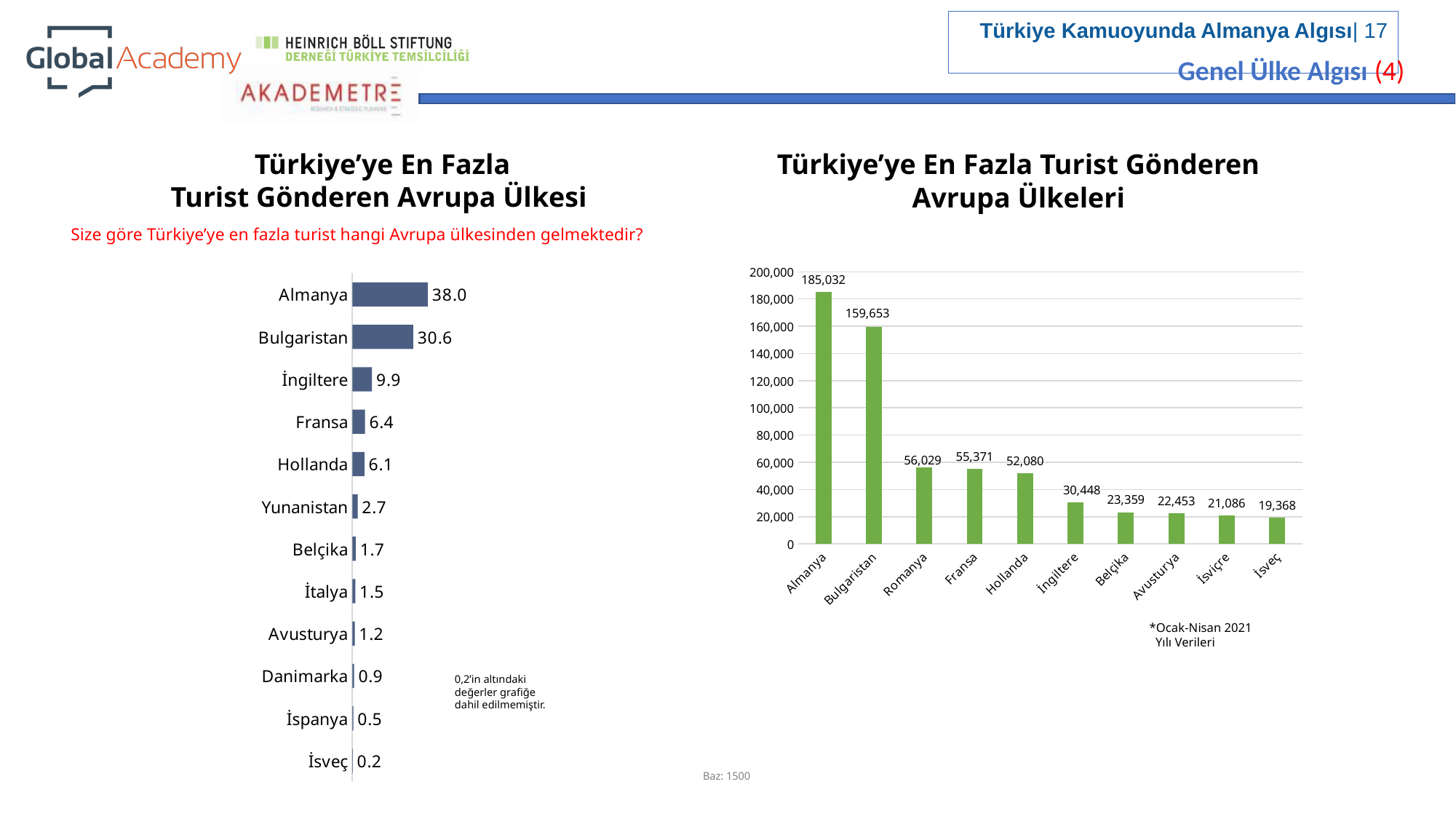
In the right chart (Türkiye'ye En Fazla Turist Gönderen Avrupa Ülkeleri), what is the value for Romanya? 56,029 In the right chart (Türkiye'ye En Fazla Turist Gönderen Avrupa Ülkeleri), do the values rise or fall from left to right along the x axis? fall In the left chart (Türkiye'ye En Fazla Turist Gönderen Avrupa Ülkesi), how many countries are listed? 12 In the left chart (Türkiye'ye En Fazla Turist Gönderen Avrupa Ülkesi), what is the difference between the values for Almanya and Bulgaristan? 7.4 In the right chart (Türkiye'ye En Fazla Turist Gönderen Avrupa Ülkeleri), what is the difference between the values for Almanya and Bulgaristan? 25,379 In the left chart (Türkiye'ye En Fazla Turist Gönderen Avrupa Ülkesi), which is larger, the value for Fransa or the value for Hollanda? Fransa In the left chart (Türkiye'ye En Fazla Turist Gönderen Avrupa Ülkesi), which country has the lowest value? İsveç In the right chart (Türkiye'ye En Fazla Turist Gönderen Avrupa Ülkeleri), which country has the highest value? Almanya What kind of chart is the right chart (Türkiye'ye En Fazla Turist Gönderen Avrupa Ülkeleri)? bar chart In the left chart (Türkiye'ye En Fazla Turist Gönderen Avrupa Ülkesi), what is the value for Hollanda? 6.1 In the left chart (Türkiye'ye En Fazla Turist Gönderen Avrupa Ülkesi), what is the value for Almanya? 38.0 In the right chart (Türkiye'ye En Fazla Turist Gönderen Avrupa Ülkeleri), what is the value for İsviçre? 21,086